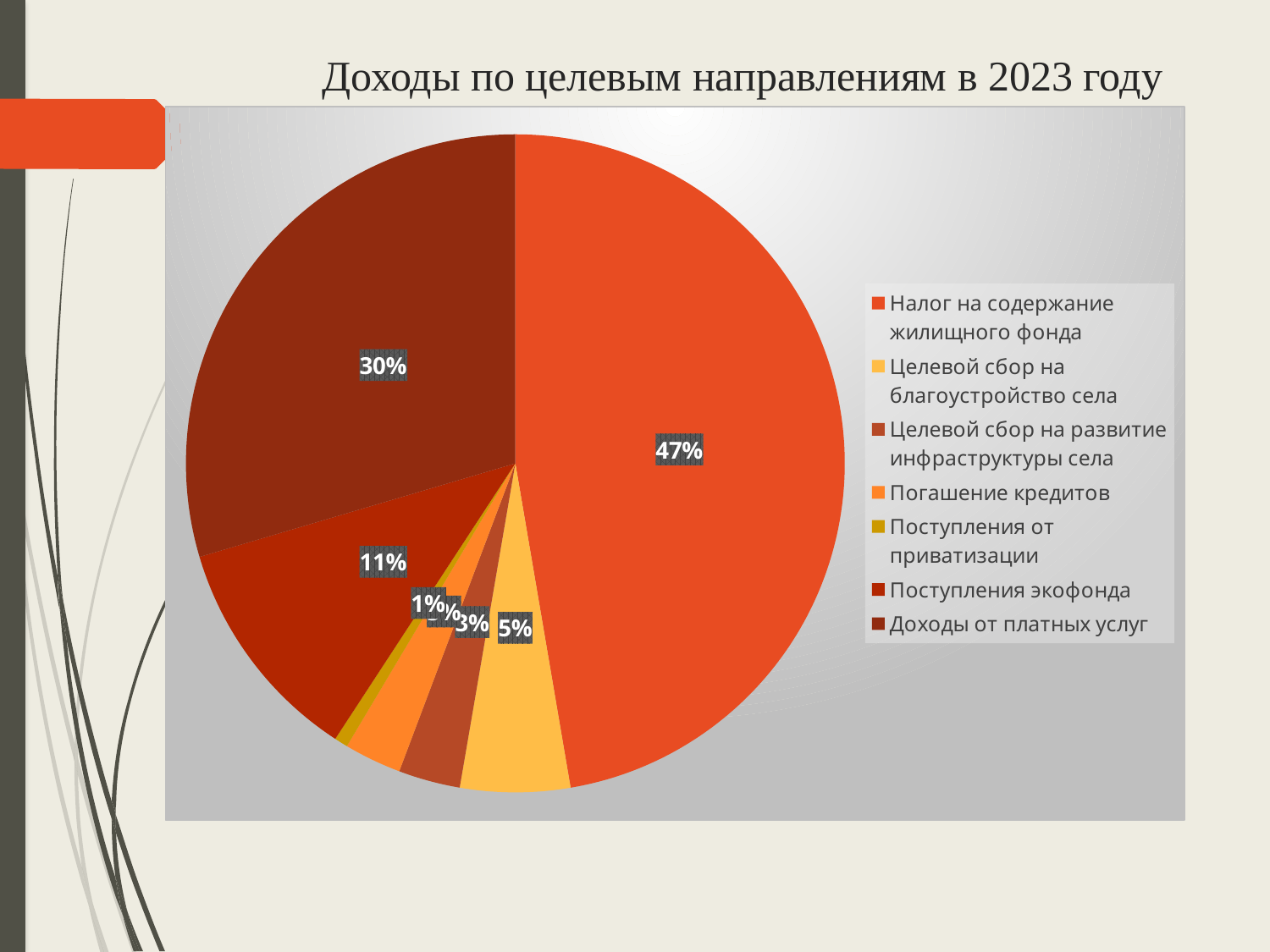
What share of the pie is labelled for "Поступления экофонда"? 11% By how many percentage points does the share of "Налог на содержание жилищного фонда" exceed the share of "Доходы от платных услуг"? 17 What share of the pie is labelled for "Налог на содержание жилищного фонда"? 47% How many categories does the legend list? 7 What share of the pie is labelled for "Целевой сбор на благоустройство села"? 5% What is the title of the chart? Доходы по целевым направлениям в 2023 году What share of the pie is labelled for "Поступления от приватизации"? 1% Which category has the largest slice of the pie? Налог на содержание жилищного фонда What kind of chart is shown on the slide? pie chart Which is larger: the share of "Доходы от платных услуг" or the share of "Поступления экофонда"? Доходы от платных услуг Which category has the smallest slice of the pie? Поступления от приватизации What share of the pie is labelled for "Доходы от платных услуг"? 30%